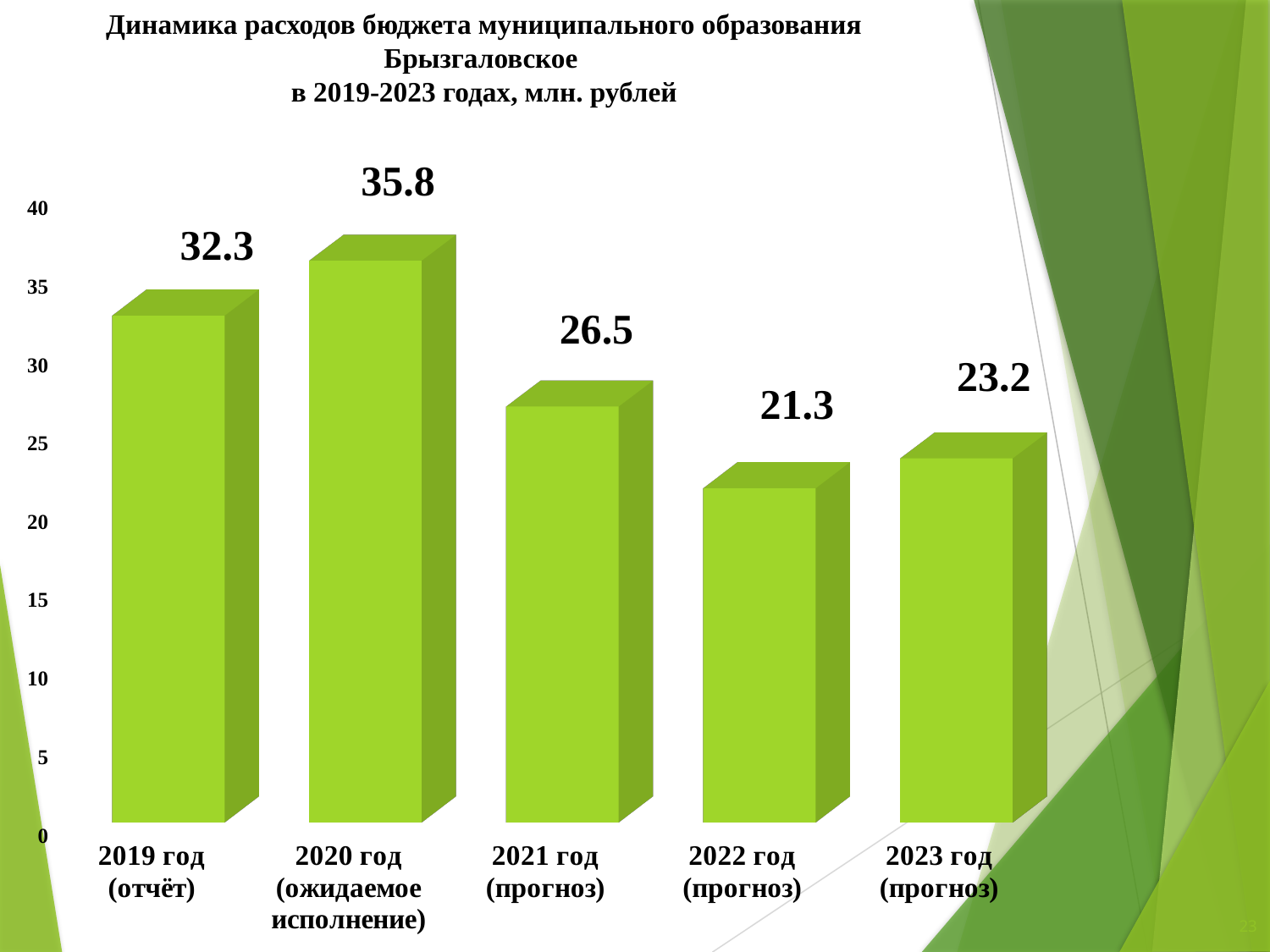
Which year has the highest value? 2020 год (ожидаемое исполнение) What is the value for 2022 год (прогноз)? 21.3 What is the value for 2020 год (ожидаемое исполнение)? 35.8 How many years are shown on the chart? 5 What is the difference between the values for 2020 год and 2021 год? 9.3 Which year has the lowest value? 2022 год (прогноз) What unit is stated in the chart title? млн. рублей What is the difference between the values for 2023 год and 2022 год? 1.9 Which is larger, the value for 2019 год or the value for 2023 год? 2019 год What is the value for 2019 год (отчёт)? 32.3 What kind of chart is shown on the slide? bar chart Is the value for 2021 год greater or less than 25? greater